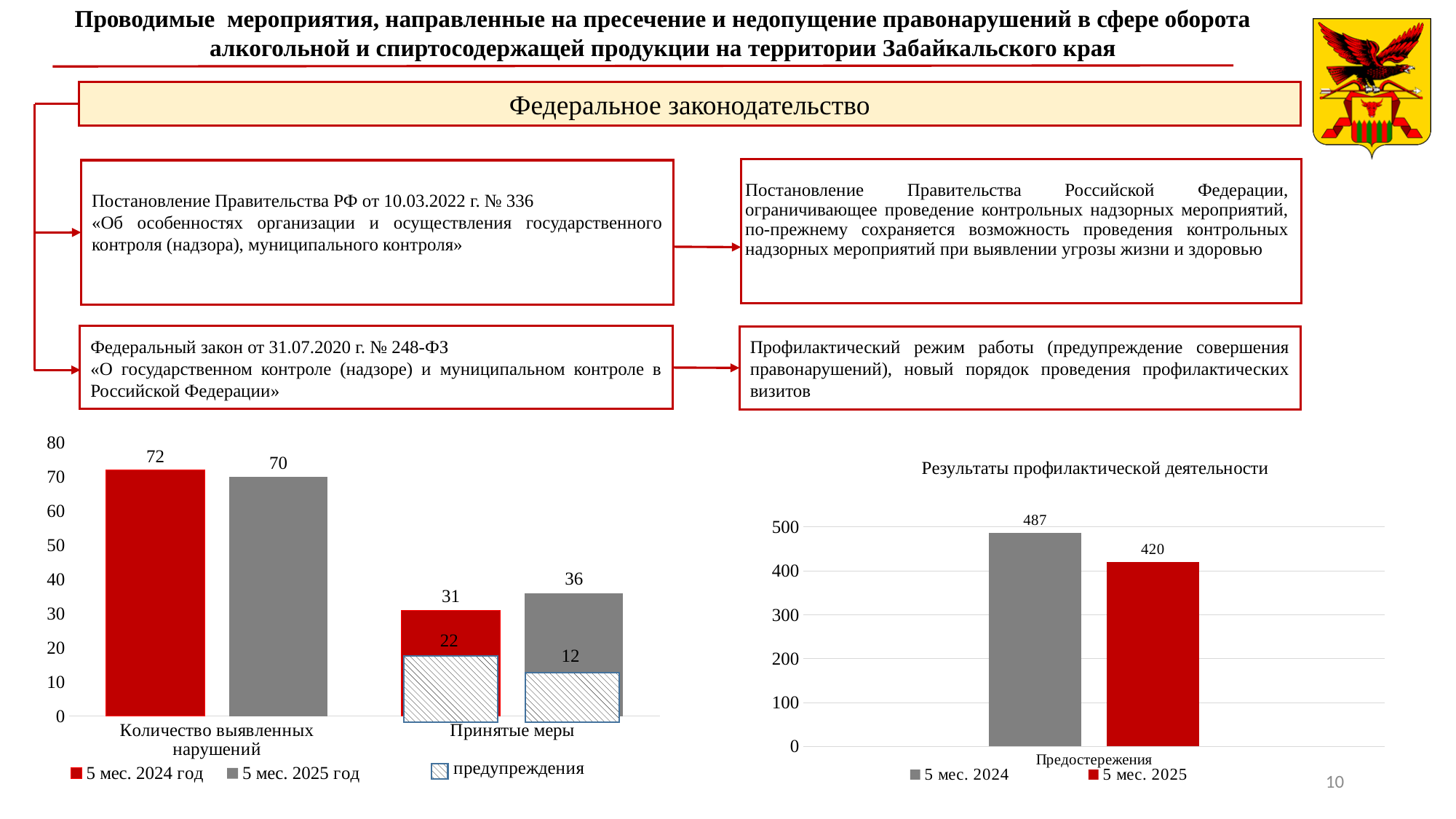
In the left chart, what is the value for 'Количество выявленных нарушений' for '5 мес. 2024 год'? 72 In the left chart, what kind of chart is shown? bar chart In the chart 'Результаты профилактической деятельности', what is the difference between the '5 мес. 2024' and '5 мес. 2025' values? 67 In the left chart, which is larger for 'Принятые меры': '5 мес. 2024 год' or '5 мес. 2025 год'? 5 мес. 2025 год In the left chart, what is the 'предупреждения' value shown within the 'Принятые меры' bar for '5 мес. 2024 год'? 22 In the left chart, what is the value for 'Принятые меры' for '5 мес. 2025 год'? 36 In the chart 'Результаты профилактической деятельности', what is the value for '5 мес. 2024'? 487 In the left chart, what is the value for 'Количество выявленных нарушений' for '5 мес. 2025 год'? 70 In the left chart, what is the difference between the 'Принятые меры' values for '5 мес. 2025 год' and '5 мес. 2024 год'? 5 In the left chart, how many entries does the legend list? 3 In the chart 'Результаты профилактической деятельности', what is the value for '5 мес. 2025'? 420 In the chart 'Результаты профилактической деятельности', what is the category label on the x axis? Предостережения